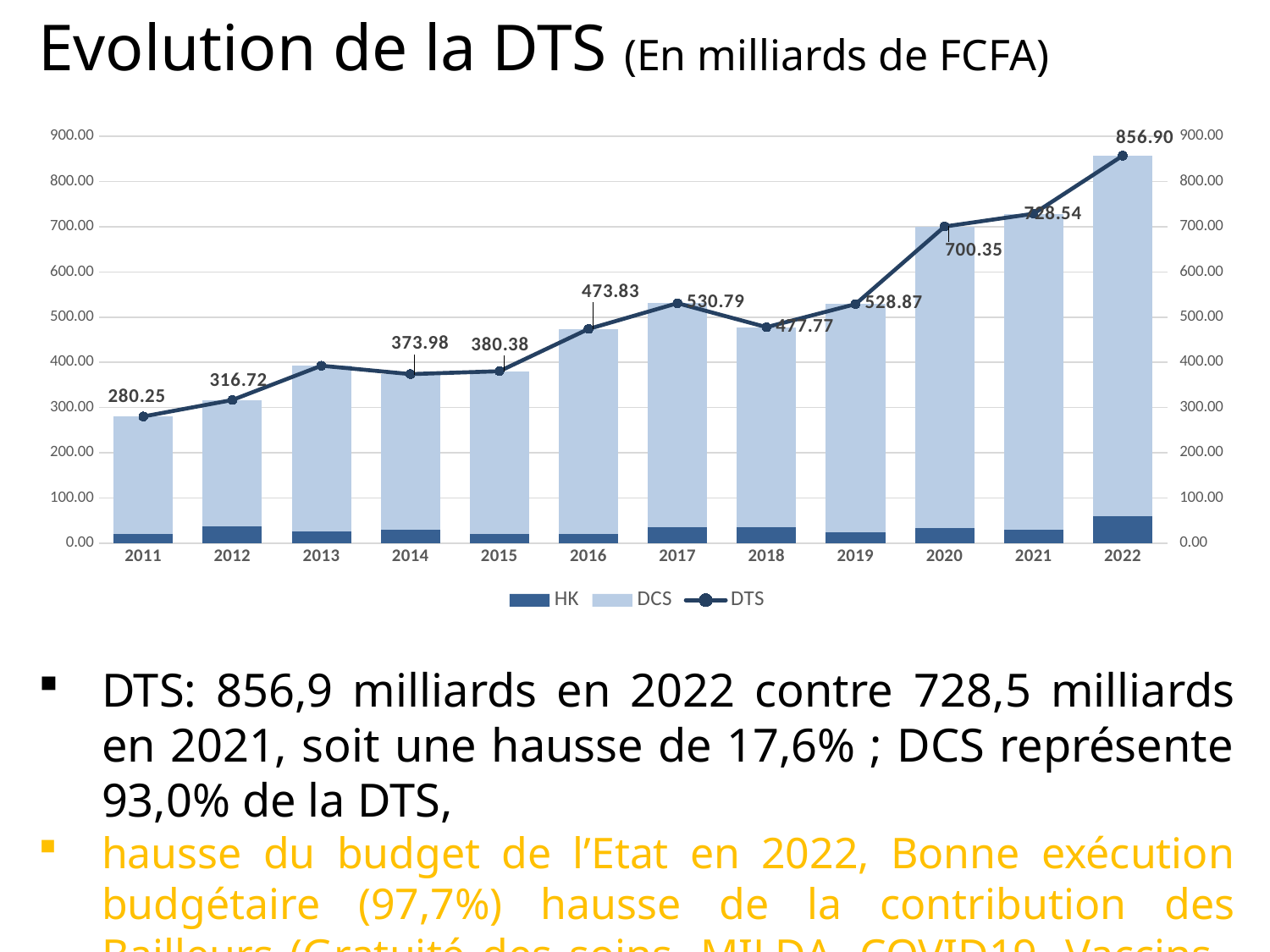
Which year has the highest DTS value? 2022 What is the DTS value for 2016? 473.83 Is the DTS value for 2013 greater or less than 300? greater What is the DTS value for 2022? 856.90 Which year has the lowest DTS value? 2011 How many years are shown on the x axis? 12 What is the difference between the DTS values for 2022 and 2021? 128.36 Which year has the larger DTS value, 2017 or 2018? 2017 What is the DTS value for 2011? 280.25 Does the DTS line generally rise or fall from 2011 to 2022? Rise What kind of chart is this? Combined stacked bar and line chart How many series does the legend list? 3